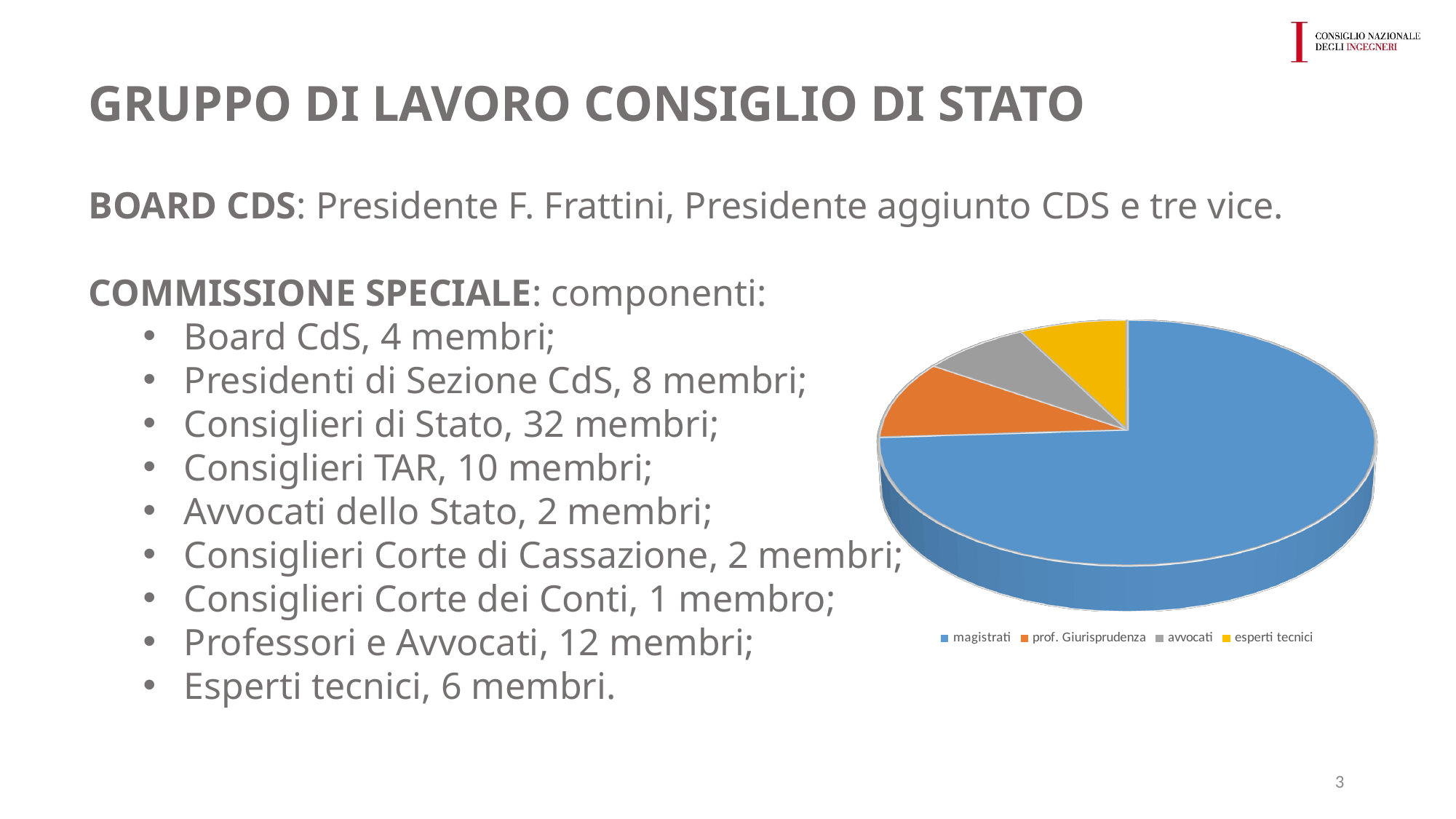
Which slice is larger in the pie chart, prof. Giurisprudenza or esperti tecnici? prof. Giurisprudenza Which category has the largest slice in the pie chart? magistrati Which slice is larger in the pie chart, magistrati or prof. Giurisprudenza? magistrati What colour is the magistrati slice in the pie chart? blue Which slice is larger in the pie chart, prof. Giurisprudenza or avvocati? prof. Giurisprudenza What kind of chart is shown on the slide? pie chart Which legend entry in the pie chart is shown in yellow? esperti tecnici How many categories does the pie chart's legend list? 4 Does the magistrati slice take up more or less than half of the pie chart? more